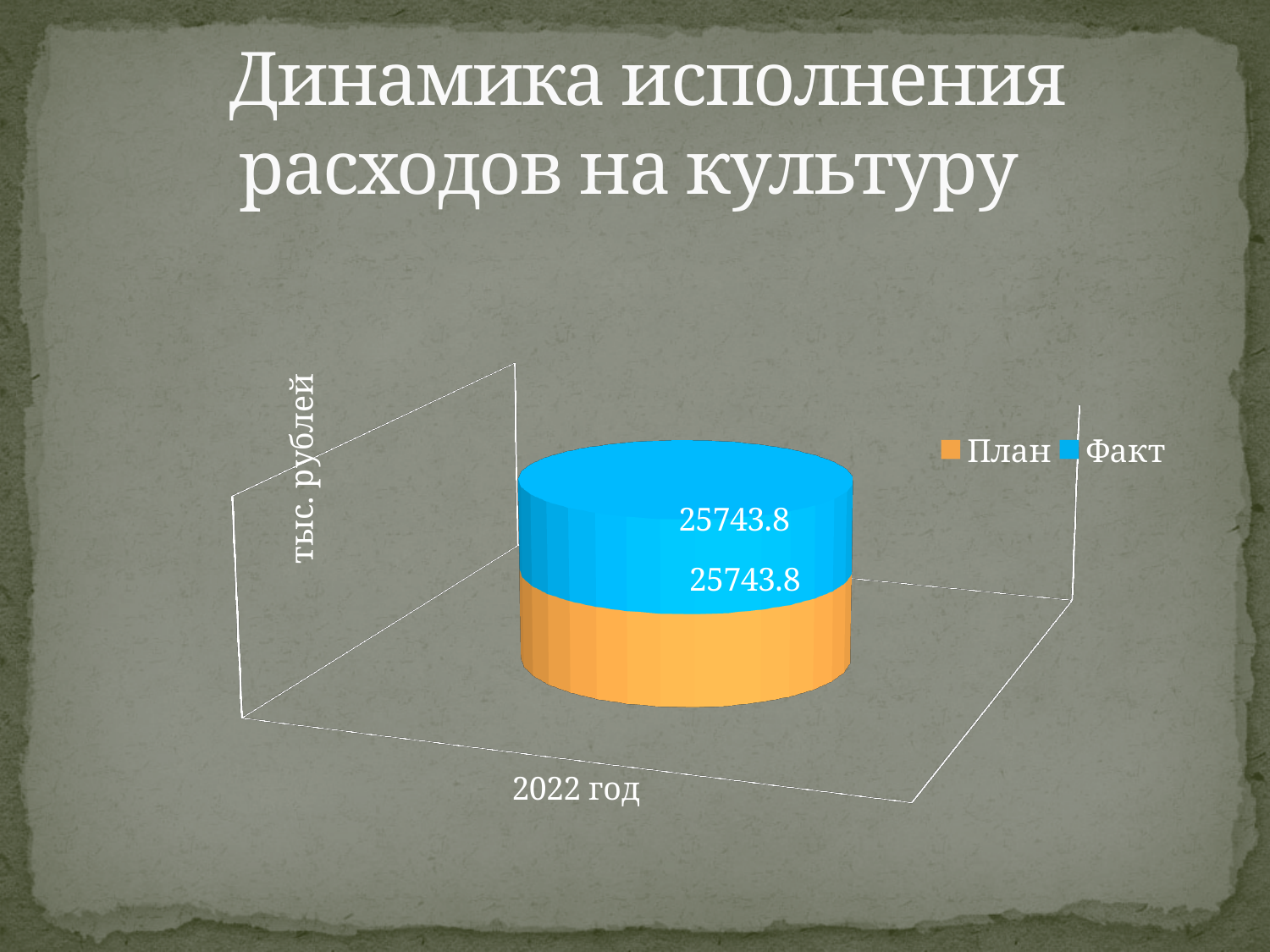
What kind of chart is shown on the slide? Bar chart How many categories are shown on the x axis? 1 What is the value for План in 2022 год? 25743.8 What is the total of the stacked bar for 2022 год? 51487.6 How many series does the legend list? 2 What is the title of the chart on the slide? Динамика исполнения расходов на культуру What is the value for Факт in 2022 год? 25743.8 Which category is shown on the x axis? 2022 год What is the difference between the Факт and План values for 2022 год? 0 What unit is given on the vertical axis label? тыс. рублей